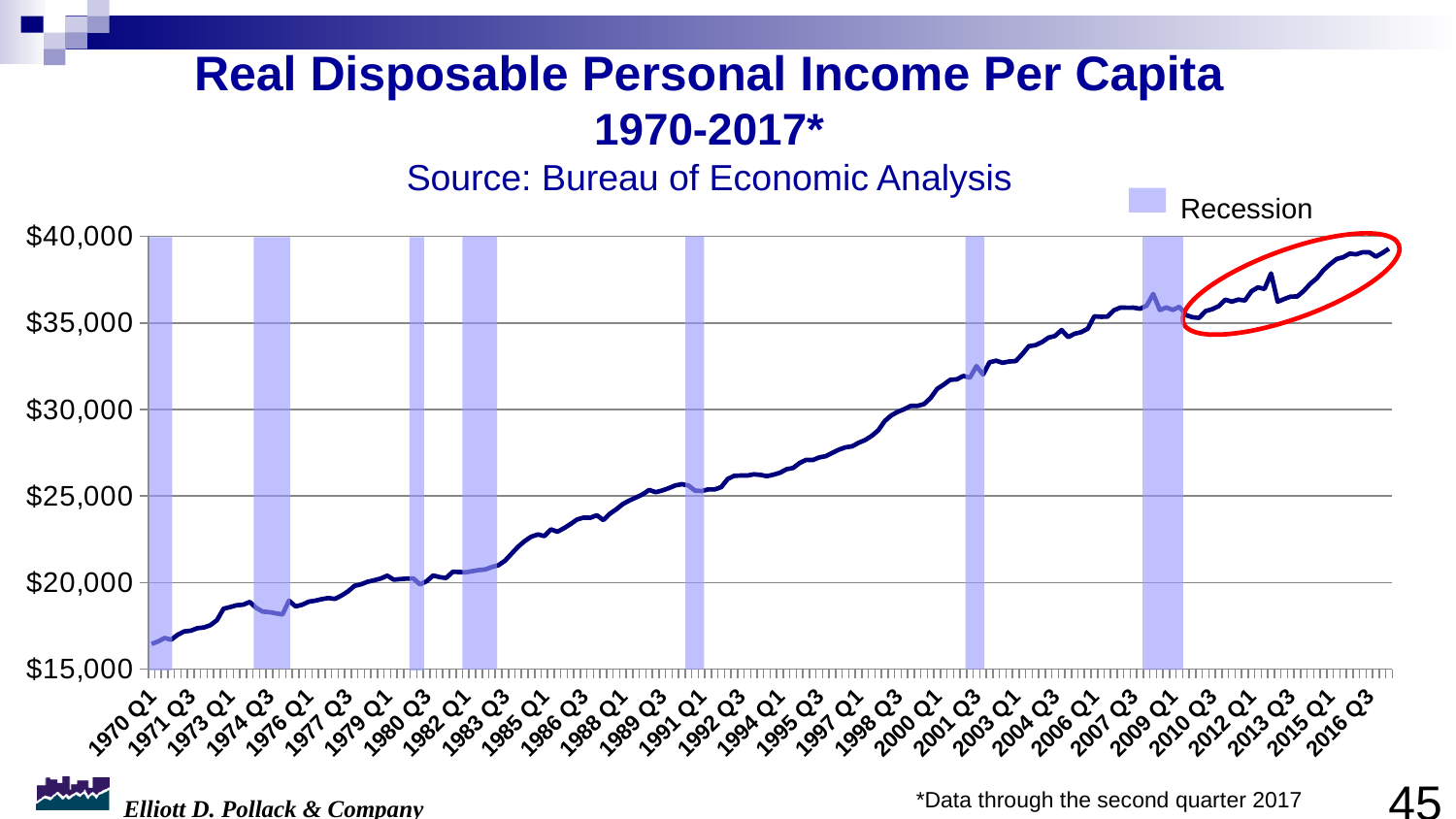
Does real disposable personal income per capita generally rise or fall from 1970 to 2017? Rise What is the lowest value shown on the vertical axis? $15,000 Is the value for 2004 Q3 greater or less than $30,000? greater What kind of chart is shown on the slide? Line chart Is the value for 1977 Q3 greater or less than $20,000? less Is the highest value on the chart found at the beginning or at the end of the series? End What is the title of the chart? Real Disposable Personal Income Per Capita 1970-2017* Is the value for 1970 Q1 greater or less than $20,000? less Which is larger, the value for 1980 Q1 or the value for 1998 Q1? 1998 Q1 What do the shaded vertical bands on the chart represent, according to the legend? Recession